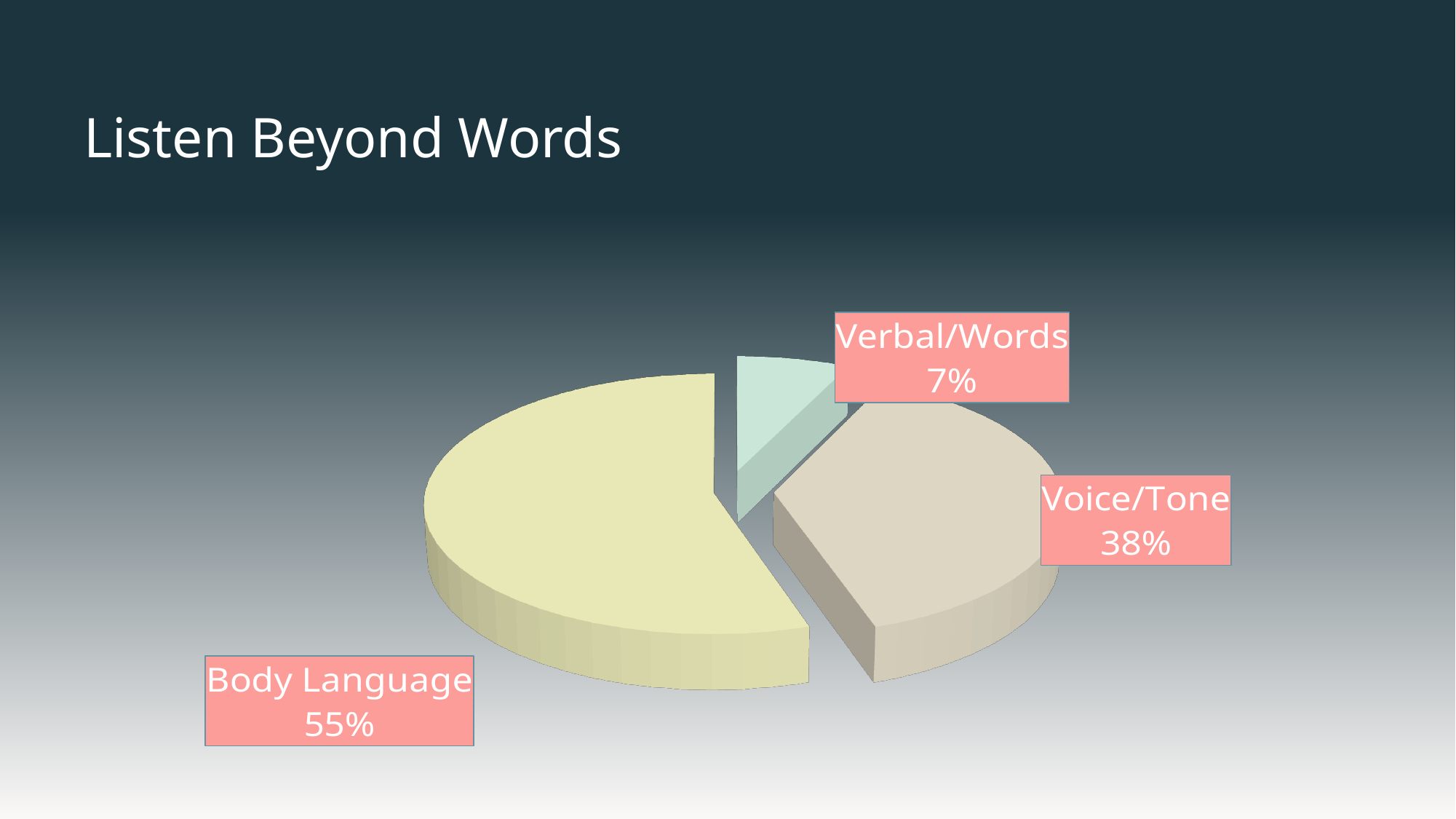
How many slices does the pie chart have? 3 What is the difference in percentage points between Body Language and Voice/Tone? 17 What is the difference in percentage points between Voice/Tone and Verbal/Words? 31 What is the title of the slide containing the pie chart? Listen Beyond Words What colour is the Body Language slice of the pie? pale yellow What share of the pie does Body Language represent? 55% Which slice of the pie is the largest? Body Language What share of the pie does Voice/Tone represent? 38% What share of the pie does Verbal/Words represent? 7% Which slice of the pie is the smallest? Verbal/Words Which is larger, Voice/Tone or Verbal/Words? Voice/Tone What kind of chart is shown on the slide? pie chart